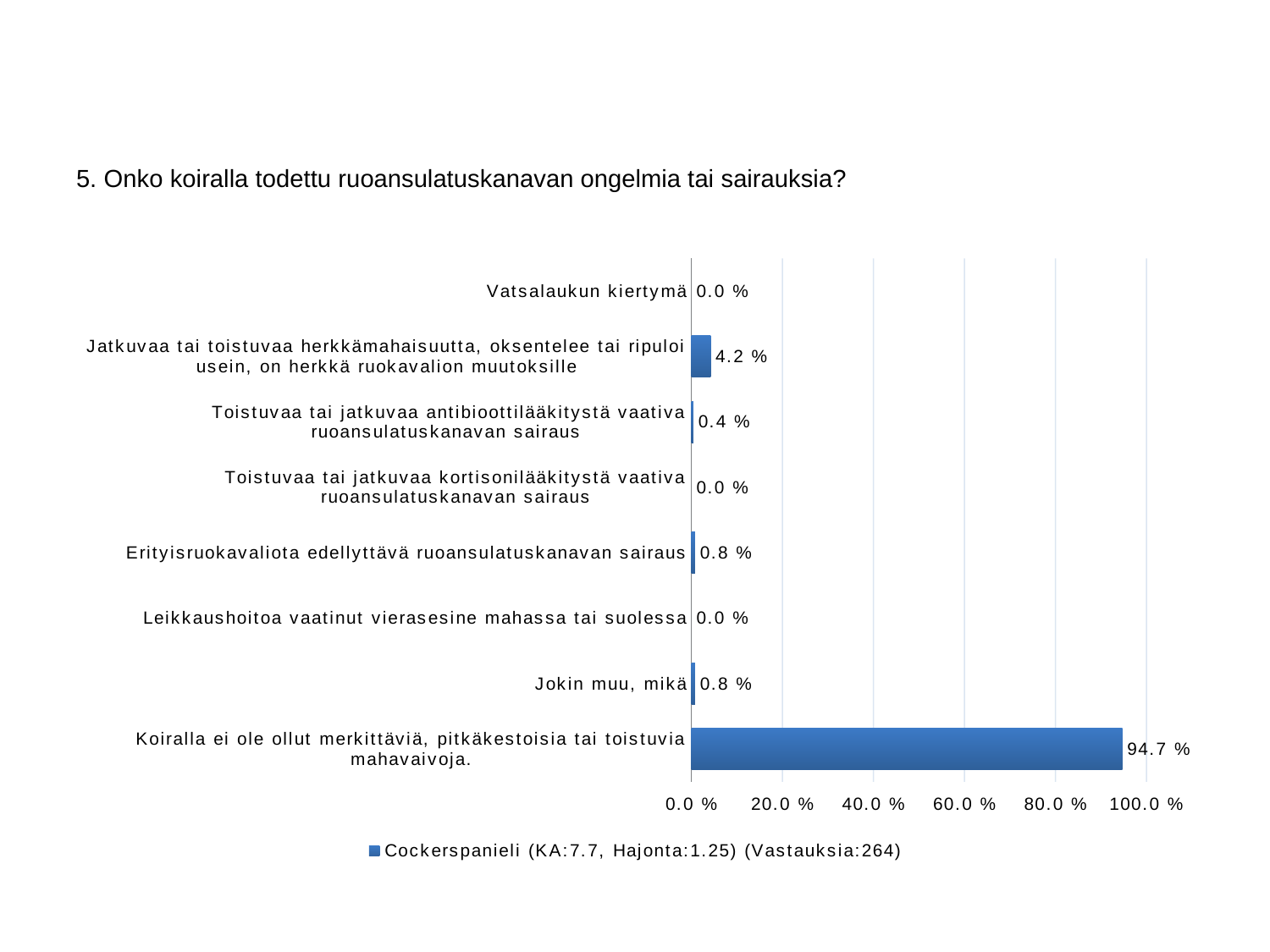
What is the value for "Toistuvaa tai jatkuvaa antibioottilääkitystä vaativa ruoansulatuskanavan sairaus"? 0.4 % Is the value for "Koiralla ei ole ollut merkittäviä, pitkäkestoisia tai toistuvia mahavaivoja." greater or less than 80.0 %? greater Which is larger: the value for "Jatkuvaa tai toistuvaa herkkämahaisuutta, oksentelee tai ripuloi usein, on herkkä ruokavalion muutoksille" or the value for "Toistuvaa tai jatkuvaa antibioottilääkitystä vaativa ruoansulatuskanavan sairaus"? Jatkuvaa tai toistuvaa herkkämahaisuutta, oksentelee tai ripuloi usein, on herkkä ruokavalion muutoksille How many categories are shown in the chart? 8 How many series does the legend list? 1 What is the value for "Jokin muu, mikä"? 0.8 % What is the difference between the values for "Jatkuvaa tai toistuvaa herkkämahaisuutta, oksentelee tai ripuloi usein, on herkkä ruokavalion muutoksille" and "Erityisruokavaliota edellyttävä ruoansulatuskanavan sairaus"? 3.4 % What is the value for "Koiralla ei ole ollut merkittäviä, pitkäkestoisia tai toistuvia mahavaivoja."? 94.7 % What is the value for "Jatkuvaa tai toistuvaa herkkämahaisuutta, oksentelee tai ripuloi usein, on herkkä ruokavalion muutoksille"? 4.2 % How many categories have a value of 0.0 %? 3 Which category has the highest value? Koiralla ei ole ollut merkittäviä, pitkäkestoisia tai toistuvia mahavaivoja. What kind of chart is shown on the slide? bar chart